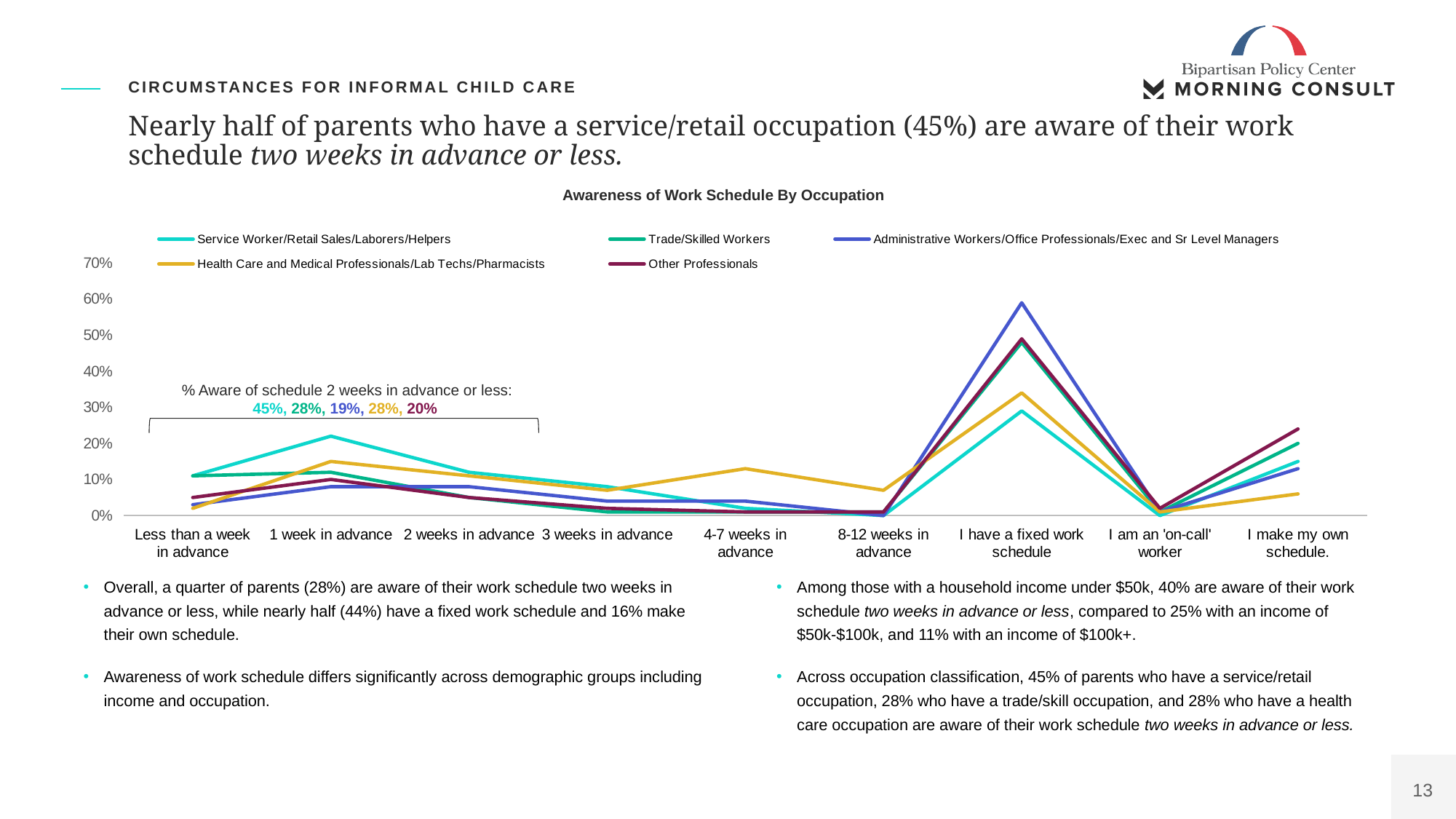
According to the annotation on the chart, what percentage of Administrative Workers/Office Professionals/Exec and Sr Level Managers are aware of their schedule 2 weeks in advance or less? 19% Is the value for Administrative Workers/Office Professionals/Exec and Sr Level Managers at 'I have a fixed work schedule' greater or less than 50%? greater What kind of chart is shown on the slide? Line chart Does the Service Worker/Retail Sales/Laborers/Helpers line rise or fall from '1 week in advance' to '8-12 weeks in advance'? Fall Which series has the highest value at 'I have a fixed work schedule'? Administrative Workers/Office Professionals/Exec and Sr Level Managers Is the value for Service Worker/Retail Sales/Laborers/Helpers at 'I have a fixed work schedule' greater or less than 40%? less According to the annotation on the chart, what percentage of Service Worker/Retail Sales/Laborers/Helpers are aware of their schedule 2 weeks in advance or less? 45% What is the title of the chart? Awareness of Work Schedule By Occupation Per the chart annotation, what is the difference between the share of Service Worker/Retail Sales/Laborers/Helpers and the share of Administrative Workers/Office Professionals/Exec and Sr Level Managers who are aware of their schedule 2 weeks in advance or less? 26 percentage points How many series does the chart's legend list? 5 Which series has the lowest value at 'I make my own schedule.'? Health Care and Medical Professionals/Lab Techs/Pharmacists How many categories are shown along the x axis of the chart? 9